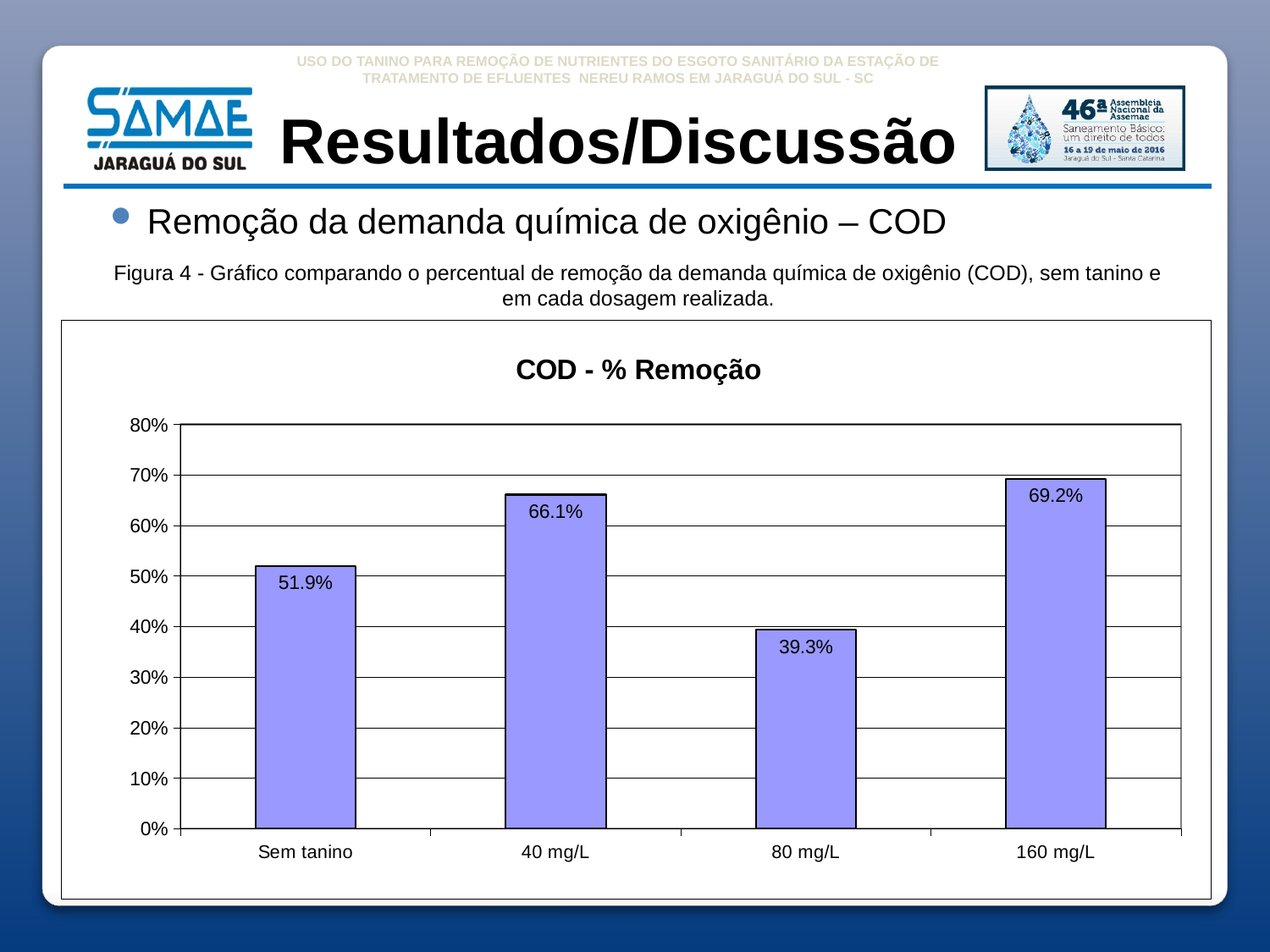
What is the COD removal percentage for 'Sem tanino'? 51.9% What is the COD removal percentage at the 160 mg/L dosage? 69.2% What is the title of the chart? COD - % Remoção What is the COD removal percentage at the 80 mg/L dosage? 39.3% Which category has the lowest COD removal percentage? 80 mg/L What is the COD removal percentage at the 40 mg/L dosage? 66.1% How many categories are shown on the x axis of the chart? 4 What is the difference in COD removal between 40 mg/L and 'Sem tanino'? 14.2% What is the difference in COD removal between 160 mg/L and 80 mg/L? 29.9% What kind of chart is shown on the slide? Bar chart Which has a higher COD removal percentage, 40 mg/L or 80 mg/L? 40 mg/L Which dosage has the highest COD removal percentage? 160 mg/L